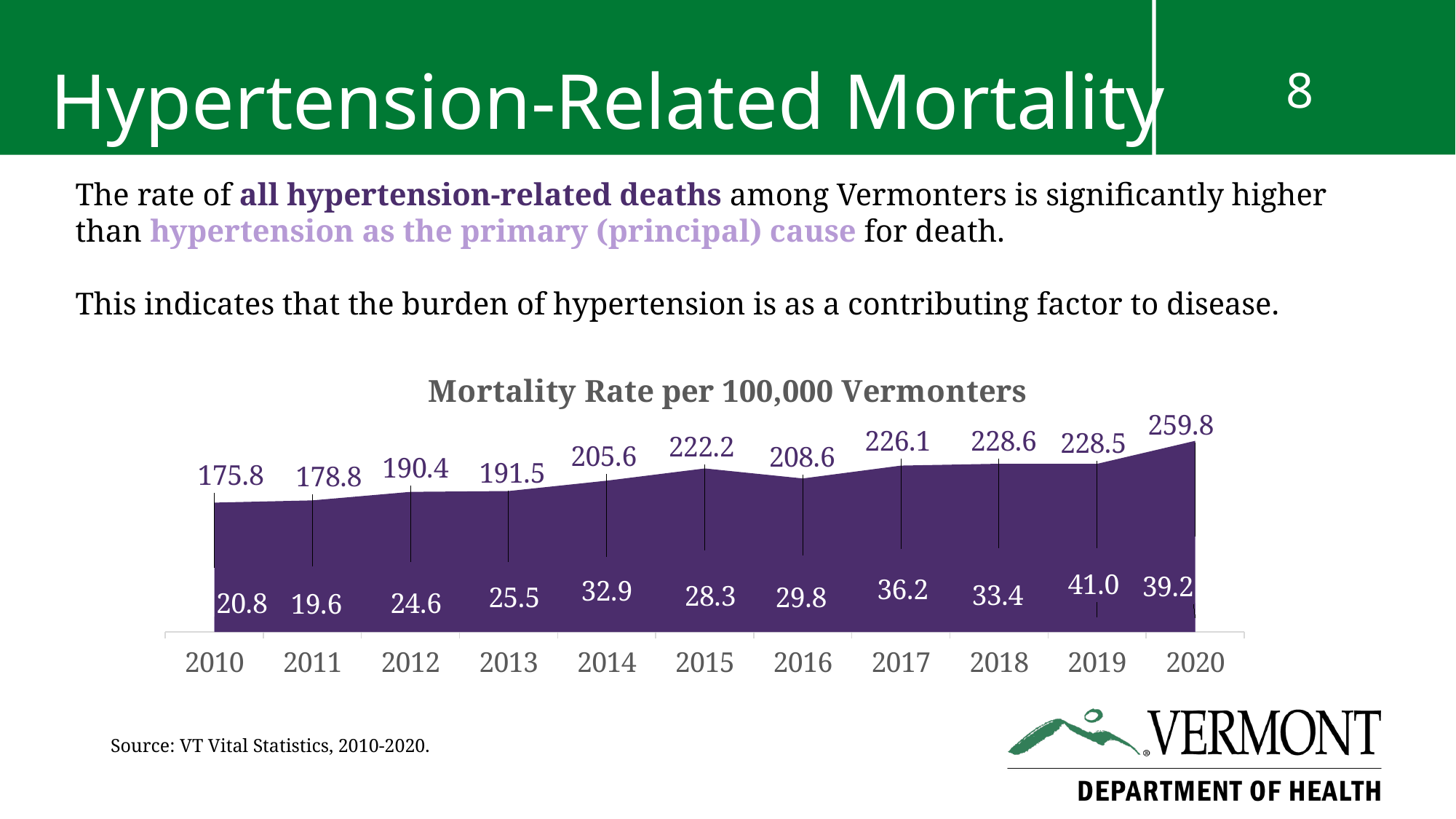
What is the title of the chart? Mortality Rate per 100,000 Vermonters What is the source cited for the chart data? VT Vital Statistics, 2010-2020 What is the mortality rate for all hypertension-related deaths in 2010? 175.8 In which year is the rate for all hypertension-related deaths highest? 2020 Which is larger: the all hypertension-related death rate in 2015 or in 2016? 2015 Does the rate for all hypertension-related deaths generally rise or fall from 2010 to 2020? Rise What is the mortality rate for all hypertension-related deaths in 2020? 259.8 What is the difference between the all hypertension-related death rate and the primary-cause rate in 2020? 220.6 How many years are shown on the x axis of the chart? 11 What is the mortality rate for hypertension as the primary cause of death in 2019? 41.0 In which year is the rate for hypertension as the primary cause of death lowest? 2011 What kind of chart is used to show the mortality rates? Area chart